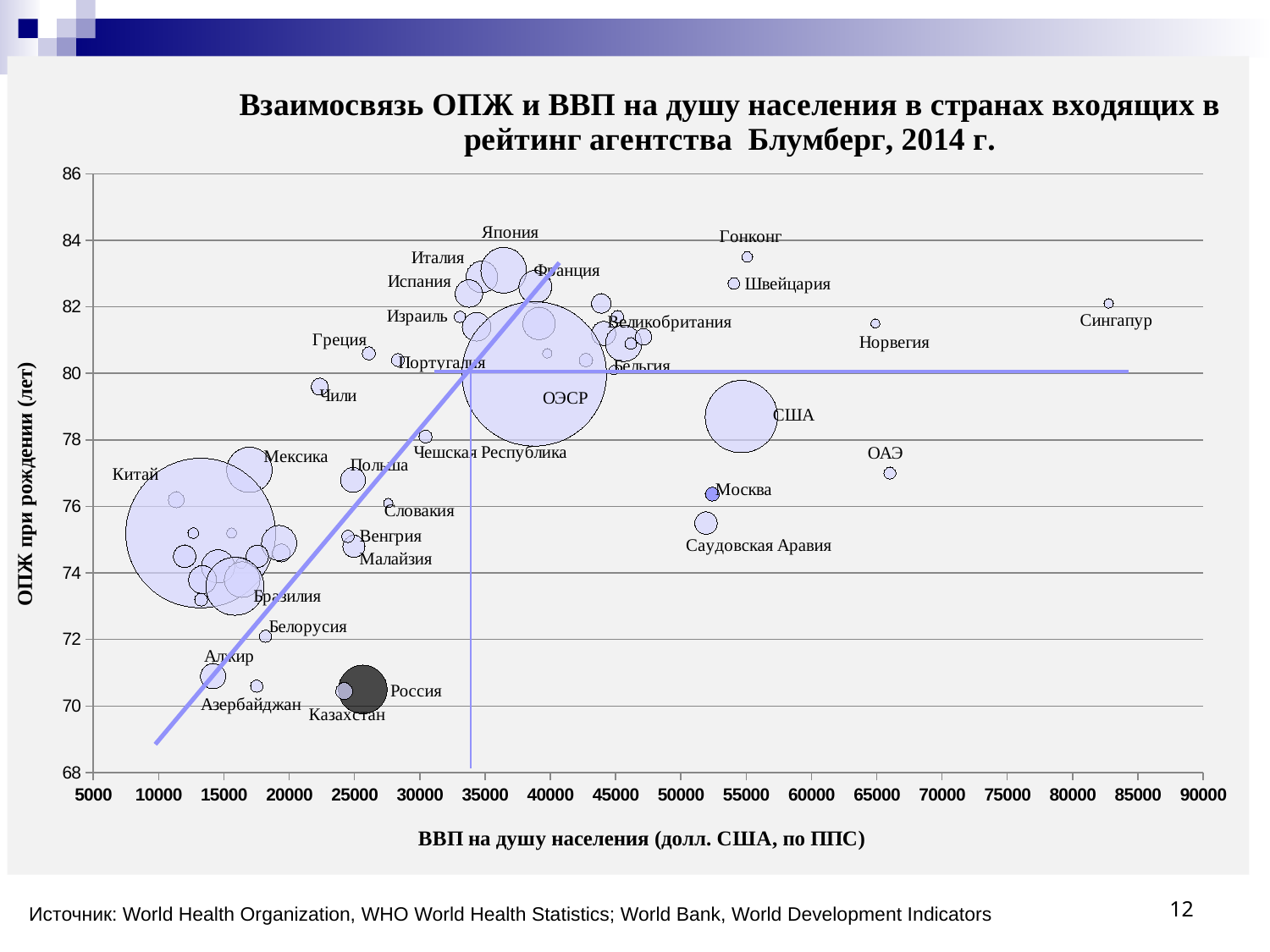
Which has the higher life expectancy, Япония or Россия? Япония Is the life expectancy for Гонконг greater or less than 82? greater Which country has the highest GDP per capita on the chart? Сингапур Is the GDP per capita for Норвегия greater or less than 60000? greater Is the life expectancy for США greater or less than 80? less Which has the higher GDP per capita, Сингапур or Китай? Сингапур What is the title of the chart? Взаимосвязь ОПЖ и ВВП на душу населения в странах входящих в рейтинг агентства Блумберг, 2014 г. What kind of chart is shown on the slide? bubble chart What is the label of the horizontal axis? ВВП на душу населения (долл. США, по ППС)